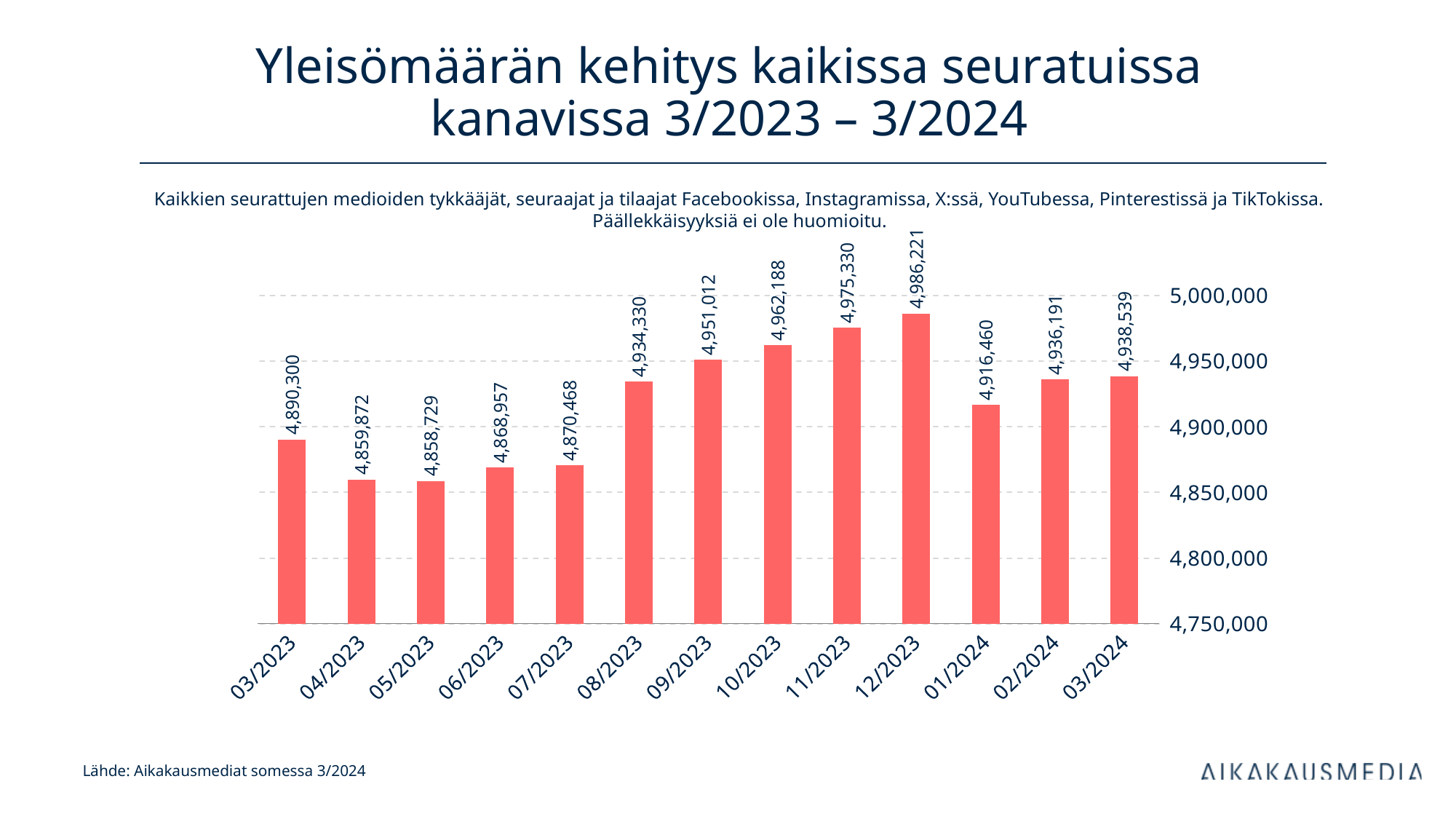
What is the value for 12/2023? 4,986,221 Which is larger, the value for 02/2024 or the value for 08/2023? 02/2024 Is the value for 08/2023 greater or less than 4,950,000? less What is the value for 01/2024? 4,916,460 What kind of chart is shown on the slide? bar chart What is the value for 03/2023? 4,890,300 What is the difference between the values for 12/2023 and 01/2024? 69,761 Which month has the lowest value? 05/2023 How many months are shown on the chart? 13 Do the values rise or fall from 07/2023 to 12/2023? rise What is the difference between the values for 03/2024 and 03/2023? 48,239 Which month has the highest value? 12/2023